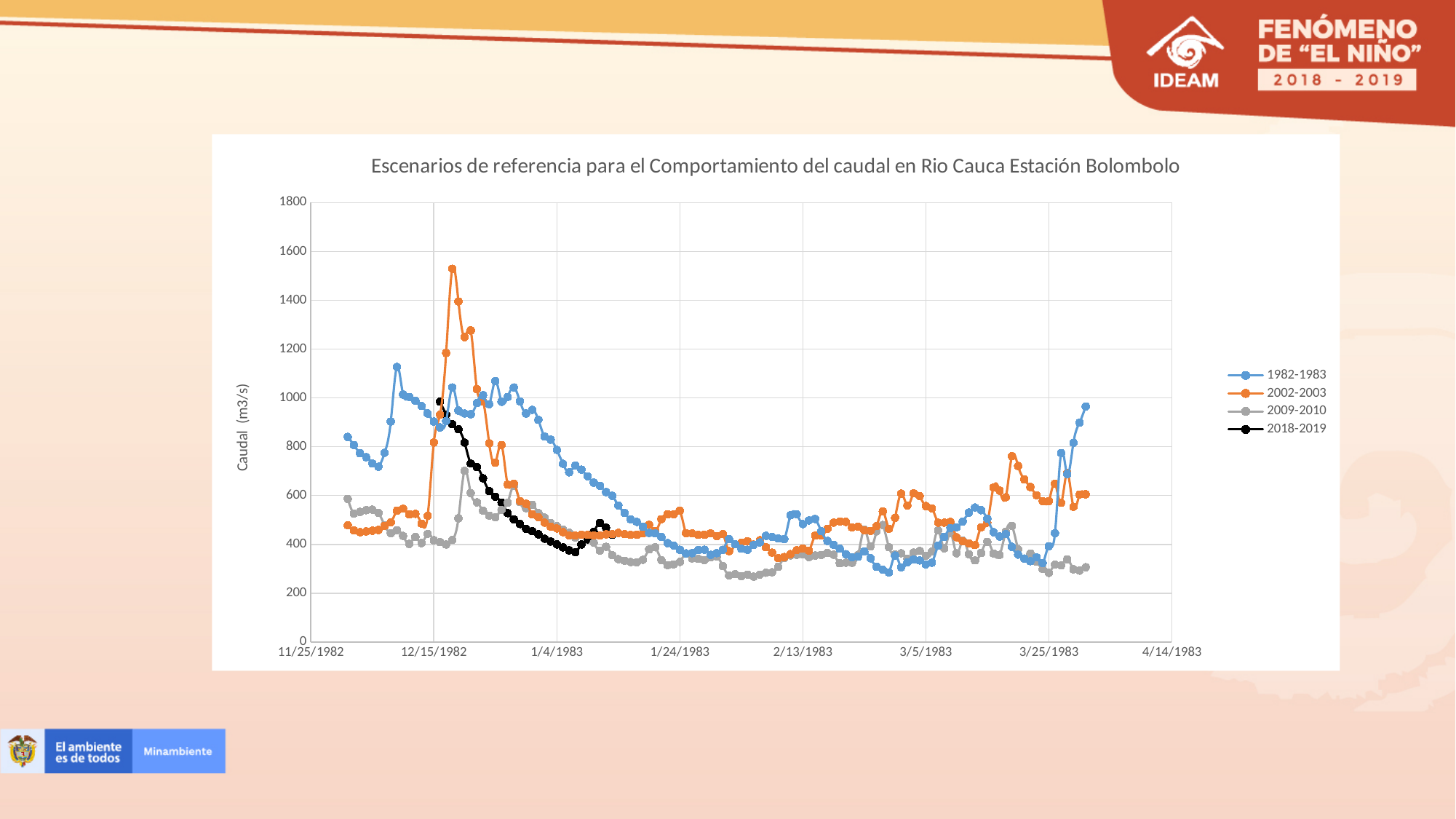
Is the peak value of the 2002-2003 series greater or less than 1400? greater Which series has the higher peak, 1982-1983 or 2009-2010? 1982-1983 Which series reaches the highest peak value on the chart? 2002-2003 Does the 2018-2019 series mainly rise or fall from its start to its end? fall Is the first value of the 2018-2019 series greater or less than 800? greater Is the peak value of the 1982-1983 series greater or less than 1200? less What is the label of the vertical axis? Caudal (m3/s) Which series ends at the highest value at the right end of the chart, 1982-1983 or 2009-2010? 1982-1983 What is the title of the chart? Escenarios de referencia para el Comportamiento del caudal en Rio Cauca Estación Bolombolo What kind of chart is shown on the slide? line chart How many series does the legend list? 4